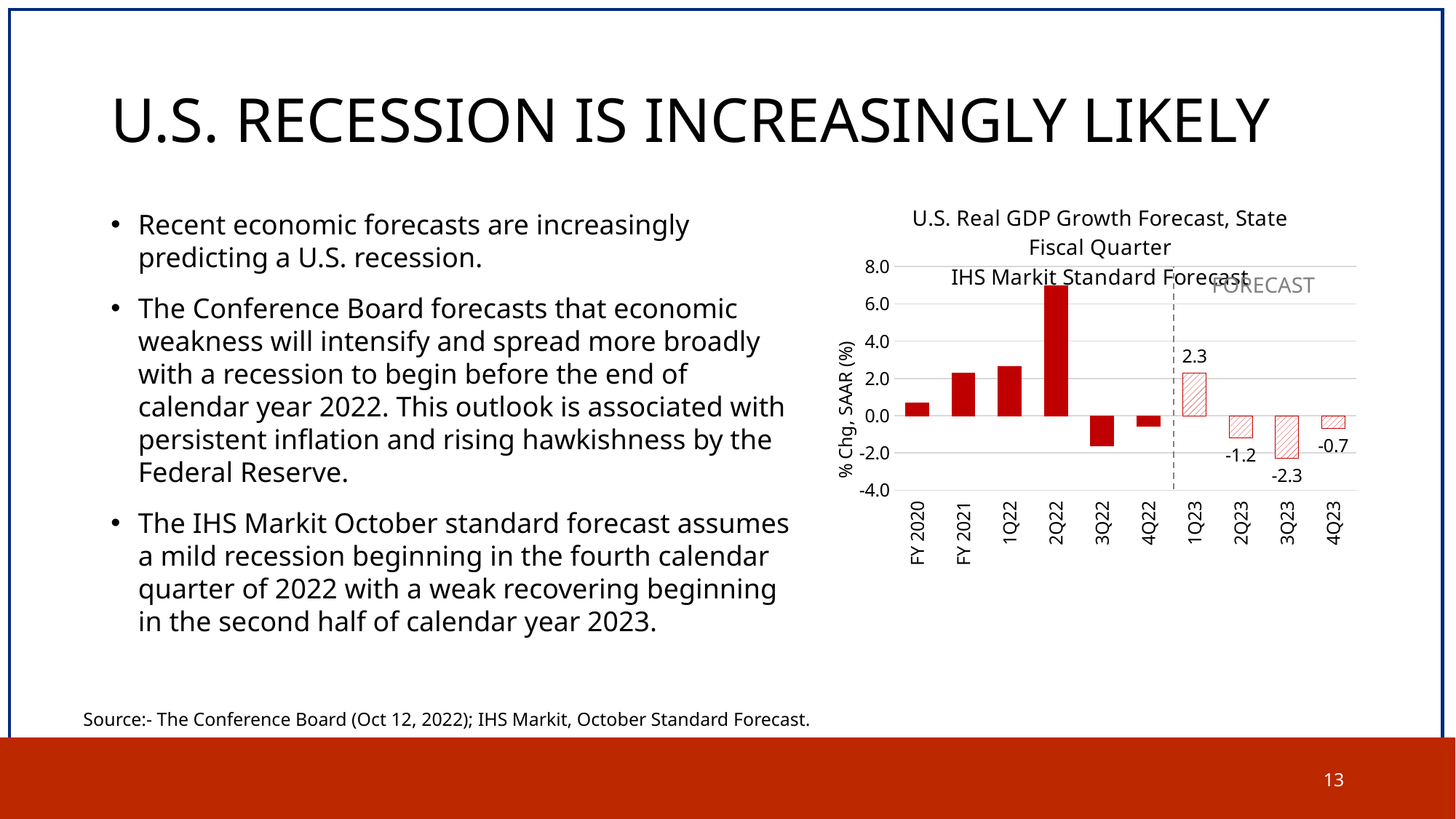
What is the label on the vertical axis of the chart? % Chg, SAAR (%) What is the forecast value for 3Q23? -2.3 What is the forecast value for 1Q23 in the U.S. Real GDP Growth Forecast chart? 2.3 Is the value for 2Q22 greater or less than 6.0? greater How many periods are shown on the x axis of the chart? 10 What value is shown for 2Q23? -1.2 What is the difference between the 1Q23 value and the 3Q23 value? 4.6 What kind of chart is used to show the U.S. Real GDP Growth Forecast? bar chart Is the value for 3Q22 greater or less than 0.0? less What value is shown for 4Q23? -0.7 Which period has the highest real GDP growth in the chart? 2Q22 Which is larger, the value for 2Q23 or the value for 4Q23? 4Q23